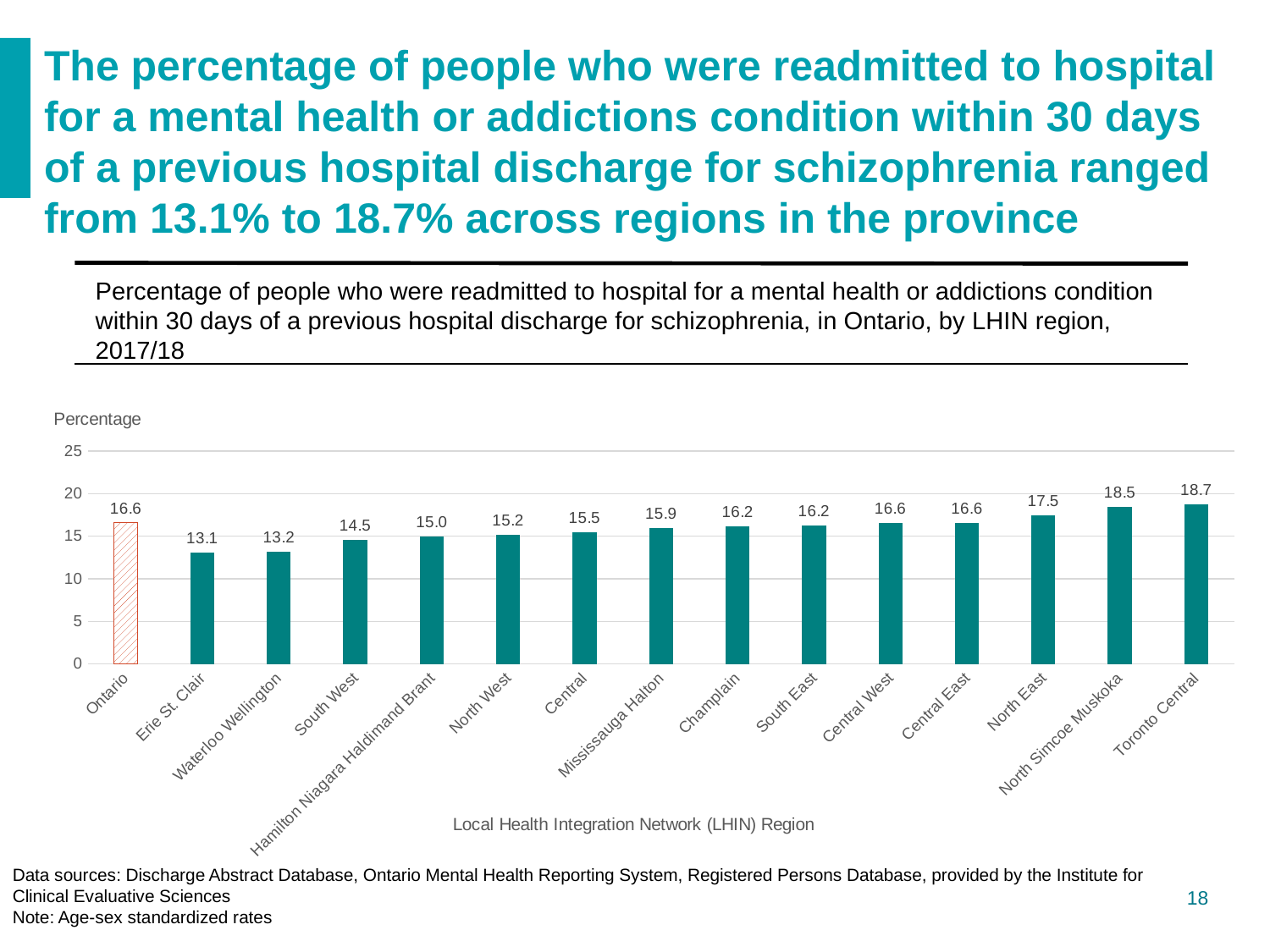
What is the difference between the values for North Simcoe Muskoka and South West? 4.0 What is the value for Erie St. Clair? 13.1 Is the value for Waterloo Wellington greater or less than 15? less What is the value for Ontario? 16.6 How many bars are shown in the chart, including Ontario? 15 What is the difference between the values for Toronto Central and Erie St. Clair? 5.6 What is the value for North East? 17.5 What kind of chart is shown on the slide? Bar chart Which LHIN region has the lowest percentage? Erie St. Clair Which LHIN region has the highest percentage? Toronto Central What is the value for Toronto Central? 18.7 Which is larger, the value for Champlain or the value for Central? Champlain